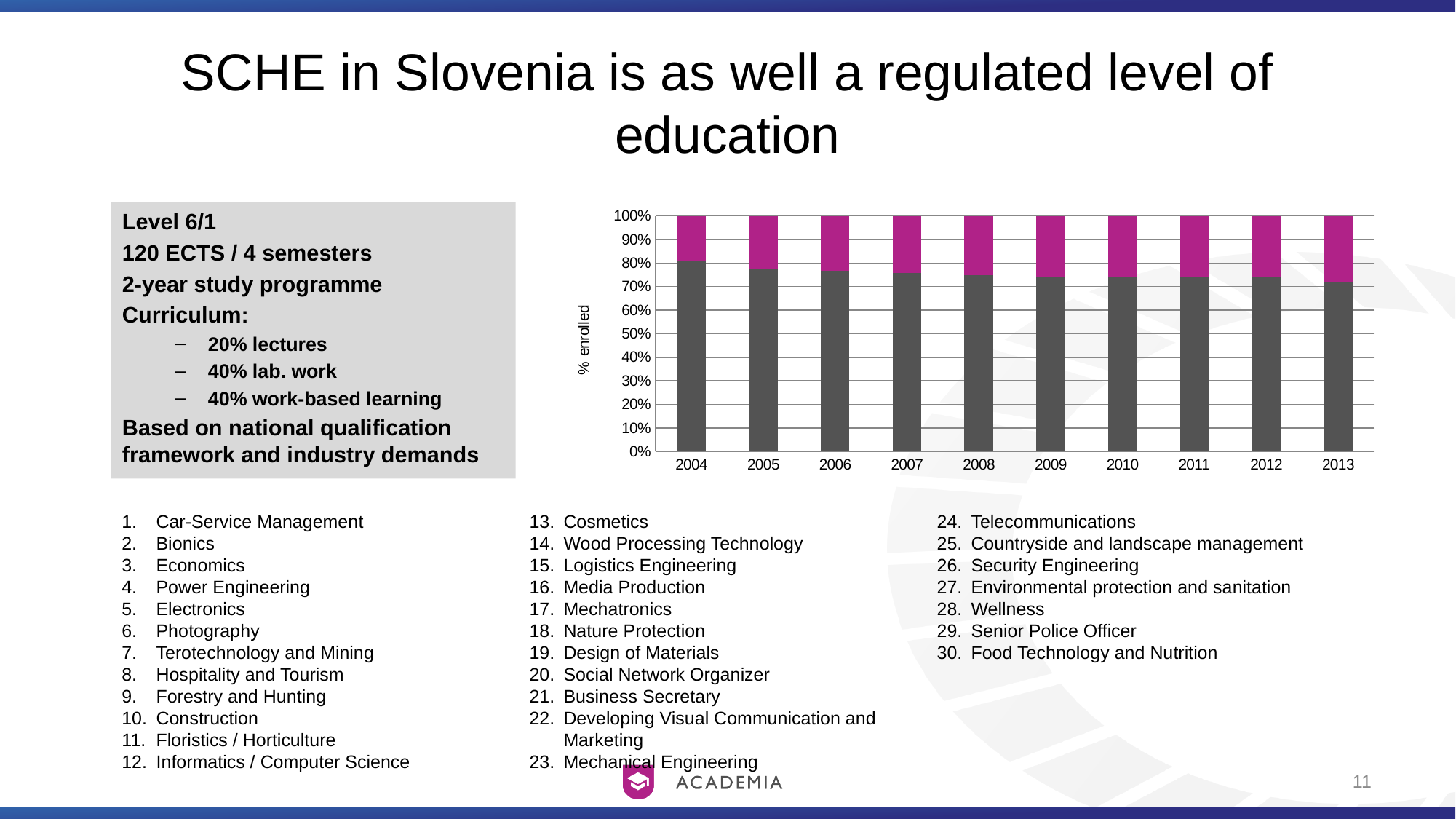
How many years are shown on the x axis of the chart? 10 Is the grey (lower) segment for 2013 greater or less than 80%? less What is the total height of the stacked bar for 2013? 100% In which year is the grey (lower) segment the largest? 2004 Which year has a larger grey (lower) segment, 2004 or 2013? 2004 Does the grey (lower) segment generally rise or fall from 2004 to 2013? fall What is the label of the y axis of the chart? % enrolled What is the first year shown on the x axis of the chart? 2004 Is the magenta (upper) segment for 2013 greater or less than 20%? greater Is the grey (lower) segment for 2004 greater or less than 70%? greater What kind of chart is shown on the slide? stacked bar chart